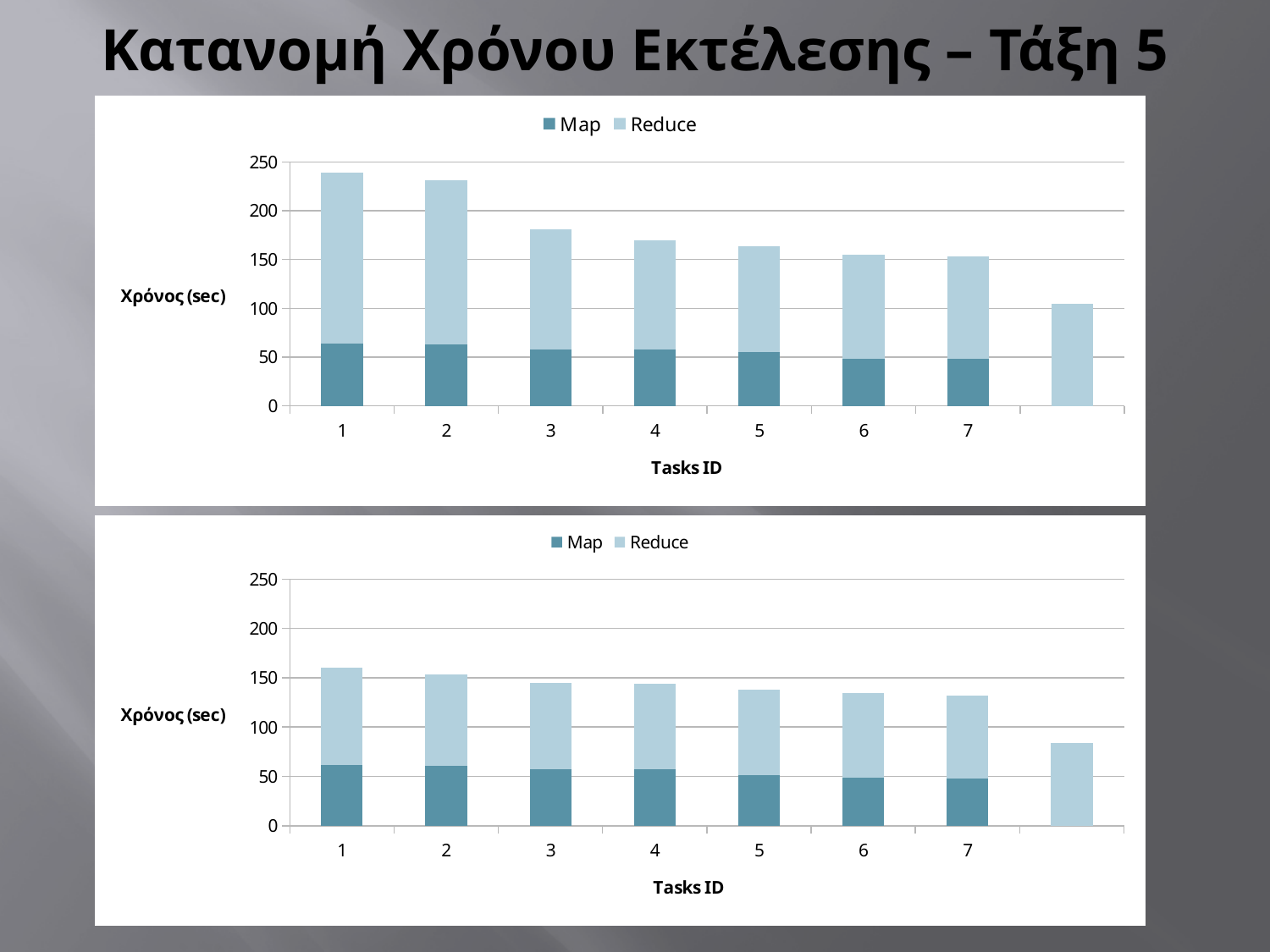
In the bottom chart, is the total value for Task ID 1 greater or less than 150? greater In the top chart, is the total value for Task ID 1 greater or less than 200? greater In the top chart, which Task ID has the highest total time? 1 In the top chart, is the Map value for Task ID 1 greater or less than 50? greater How many series does the legend of the top chart list? 2 Which two series are listed in the legend of the bottom chart? Map and Reduce What kind of chart is the top chart on the slide? Stacked bar chart In the bottom chart, which has the larger total time, Task ID 1 or Task ID 5? Task ID 1 What is the y-axis title of the top chart? Χρόνος (sec) In the top chart, do the total bar heights rise or fall as the Task ID increases from 1 to 7? fall